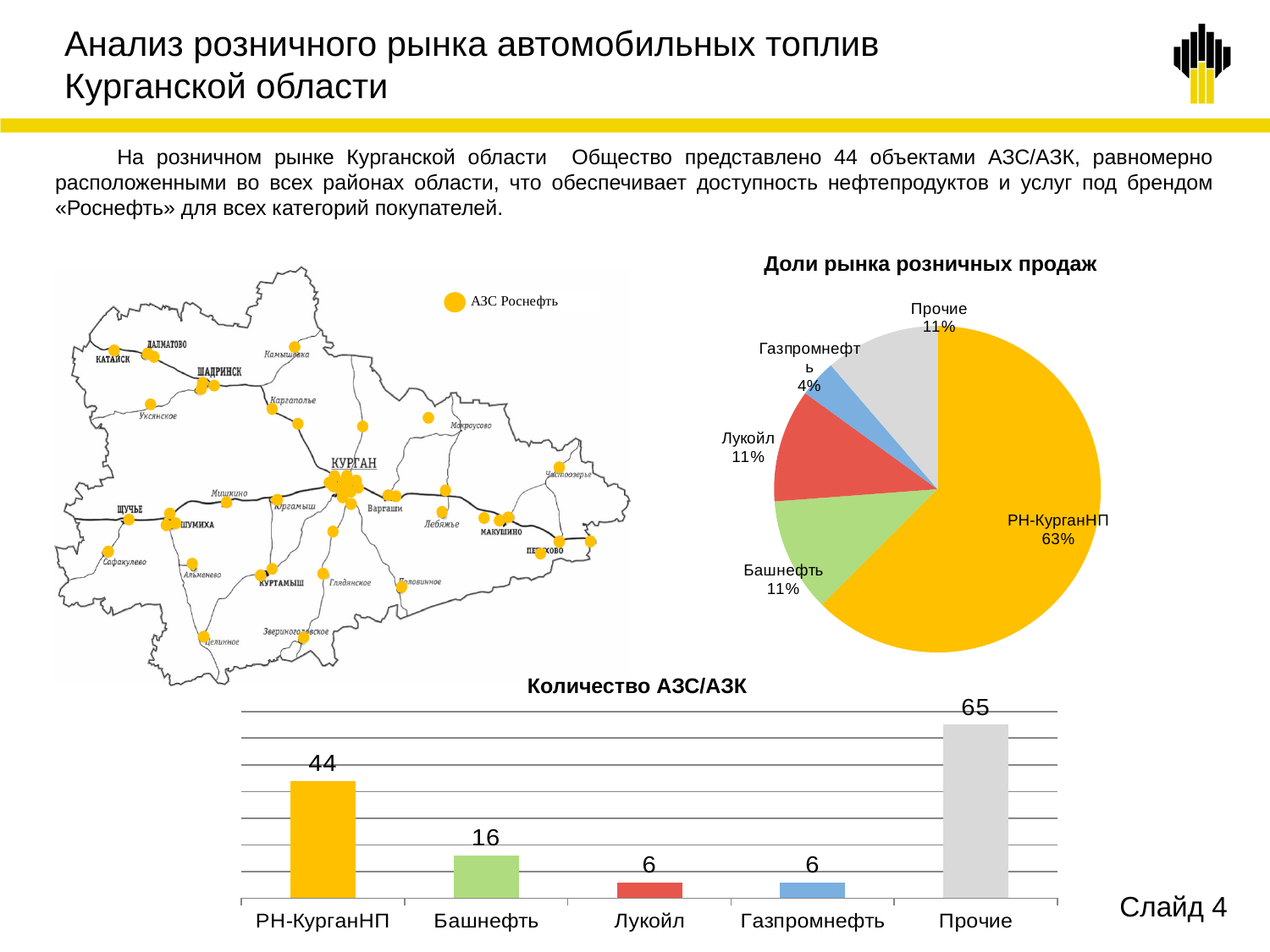
In the bar chart 'Количество АЗС/АЗК', which category has the highest value? Прочие In the pie chart 'Доли рынка розничных продаж', what share does РН-КурганНП hold? 63% In the bar chart 'Количество АЗС/АЗК', what is the difference between Прочие and РН-КурганНП? 21 In the bar chart 'Количество АЗС/АЗК', what is the value for Башнефть? 16 In the pie chart 'Доли рынка розничных продаж', which company has the smallest share? Газпромнефть In the bar chart 'Количество АЗС/АЗК', what is the value for РН-КурганНП? 44 In the bar chart 'Количество АЗС/АЗК', which is larger: Башнефть or Лукойл? Башнефть In the pie chart 'Доли рынка розничных продаж', how many slices are shown? 5 In the bar chart 'Количество АЗС/АЗК', how many categories are shown on the x axis? 5 In the pie chart 'Доли рынка розничных продаж', what share does Газпромнефть hold? 4% What type of chart is 'Доли рынка розничных продаж'? pie chart What type of chart is 'Количество АЗС/АЗК'? bar chart